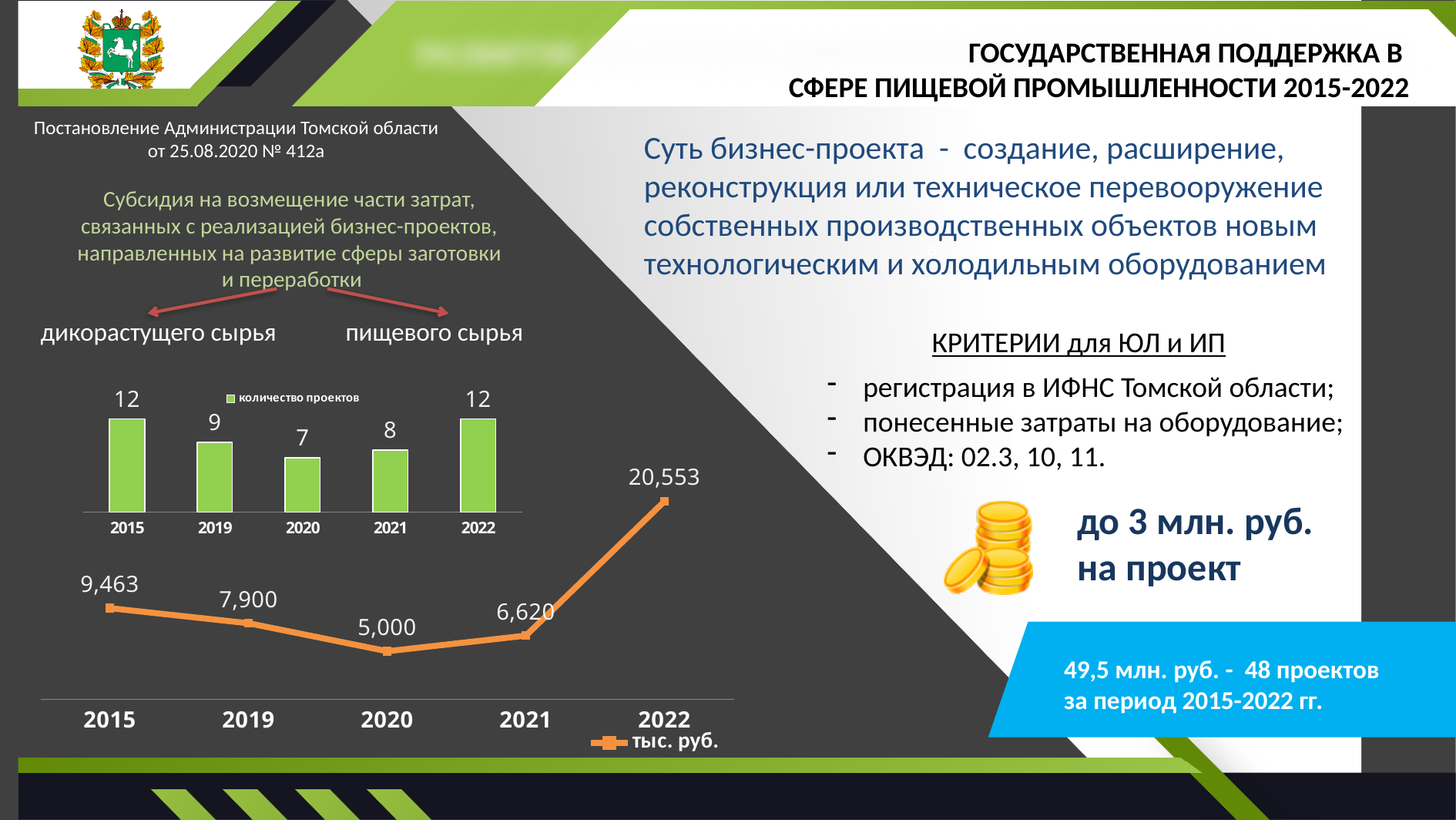
In the bar chart (количество проектов), how many projects are shown for 2019? 9 In the bar chart (количество проектов), how many categories (years) are shown on the x axis? 5 In the line chart (тыс. руб.), do the values rise or fall from 2015 to 2020? fall In the line chart (тыс. руб.), what is the value for 2022? 20,553 In the line chart (тыс. руб.), which is larger: the value for 2015 or the value for 2019? 2015 In the bar chart (количество проектов), which year has the lowest number of projects? 2020 What kind of chart is the upper chart (количество проектов)? bar chart In the line chart (тыс. руб.), what is the value for 2020? 5,000 In the line chart (тыс. руб.), what is the difference between the values for 2021 and 2020? 1,620 In the bar chart (количество проектов), what is the difference between the values for 2015 and 2021? 4 In the bar chart (количество проектов), how many projects are shown for 2020? 7 In the line chart (тыс. руб.), which year has the highest value? 2022